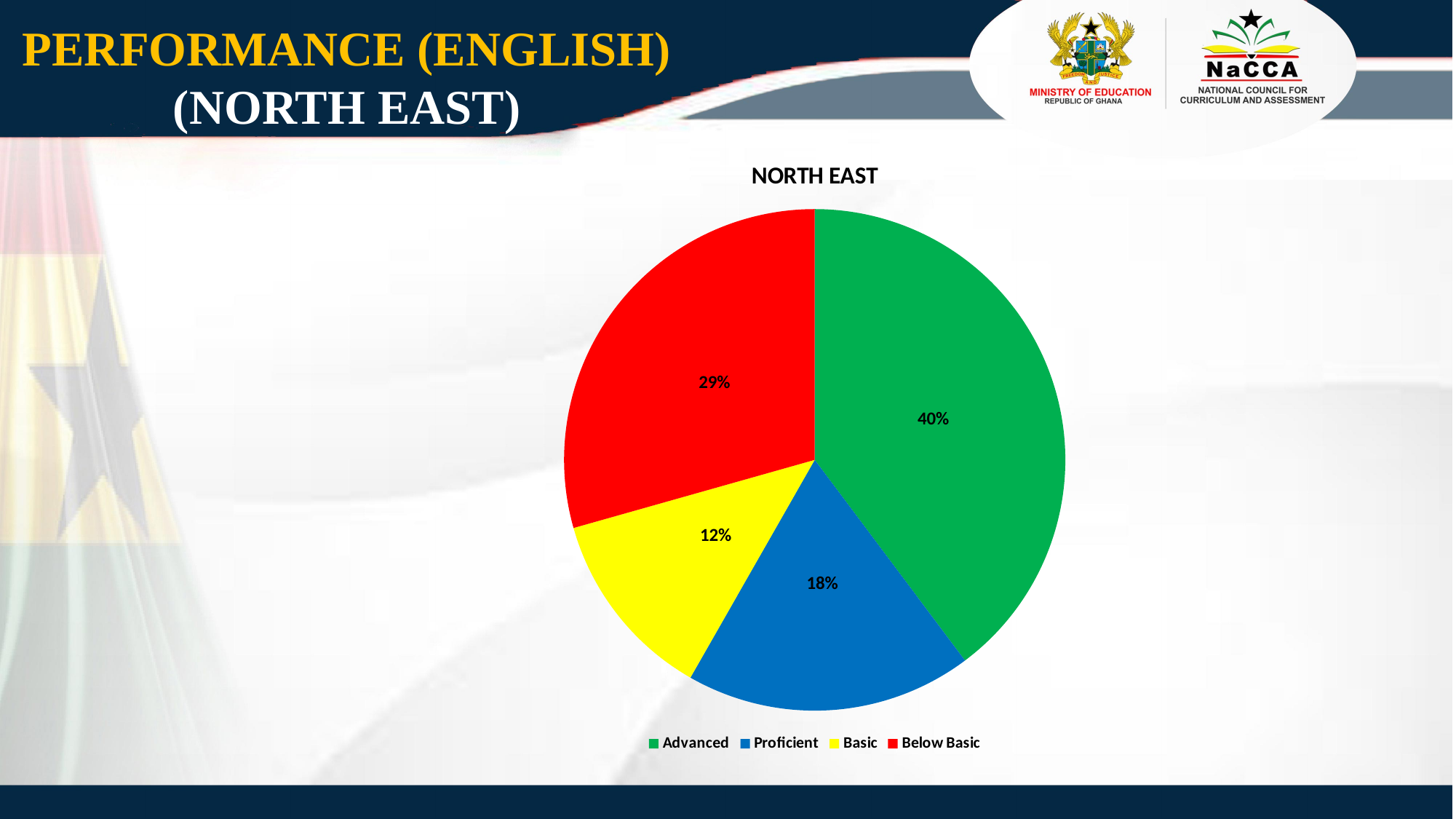
Which category has the largest share of the pie? Advanced Which category has the smallest share of the pie? Basic What percentage of the pie is Advanced? 40% How many categories does the legend list? 4 What percentage of the pie is Basic? 12% What is the title of the chart? NORTH EAST What percentage of the pie is Proficient? 18% What percentage of the pie is Below Basic? 29% What is the difference in percentage points between Advanced and Below Basic? 11 Which is larger, Proficient or Basic? Proficient What type of chart is shown on the slide? pie chart What colour represents Below Basic in the chart? red